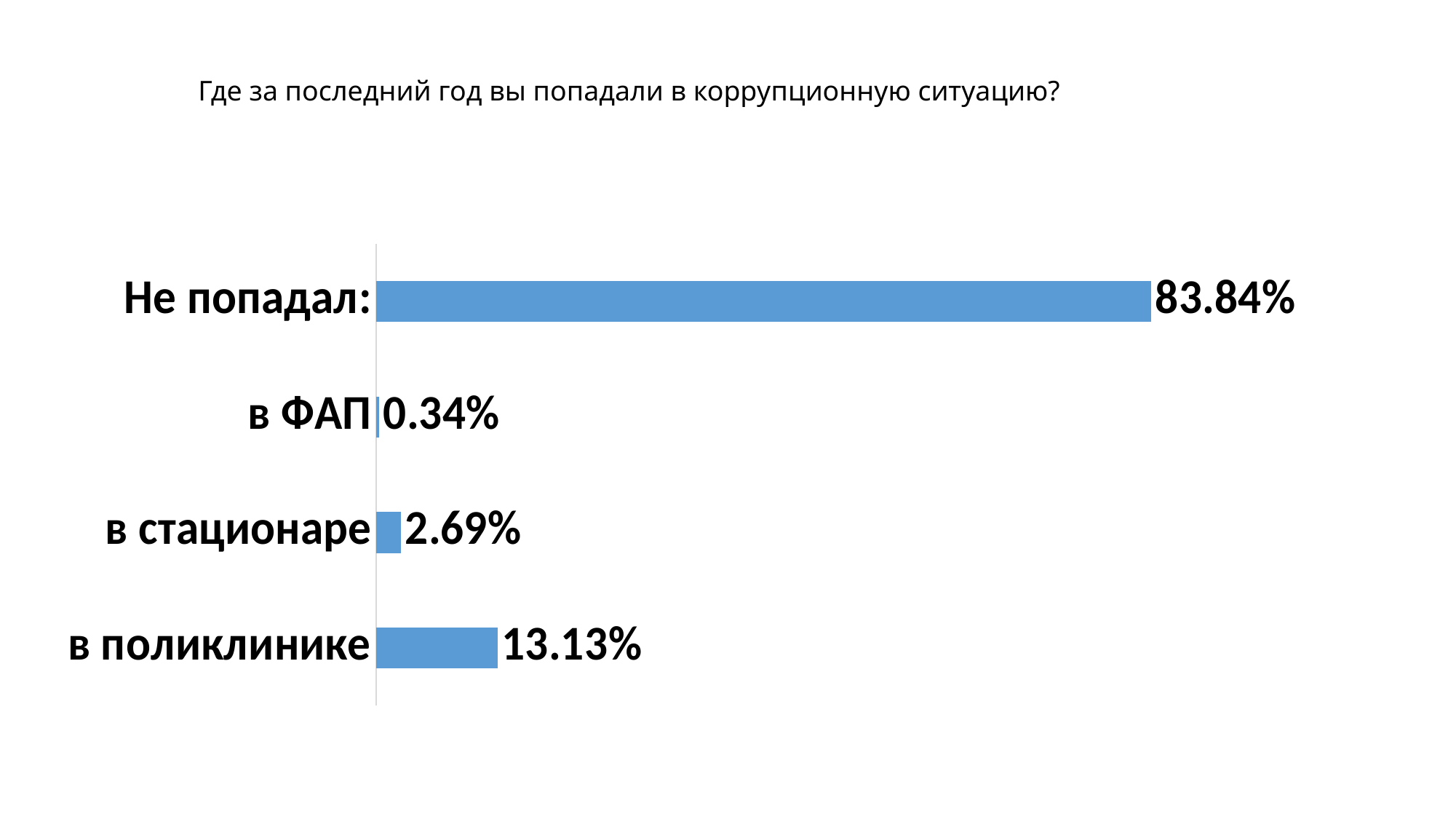
Which category has the highest value? Не попадал: What is the value for "в стационаре"? 2.69% What is the value for "Не попадал:"? 83.84% What is the difference between the values for "Не попадал:" and "в поликлинике"? 70.71% Which category has the lowest value? в ФАП What is the difference between the values for "в поликлинике" and "в стационаре"? 10.44% What is the value for "в поликлинике"? 13.13% How many categories are shown in the chart? 4 What is the title of the chart? Где за последний год вы попадали в коррупционную ситуацию? What kind of chart is shown on the slide? bar chart What is the value for "в ФАП"? 0.34% Which is larger, the value for "в стационаре" or the value for "в ФАП"? в стационаре